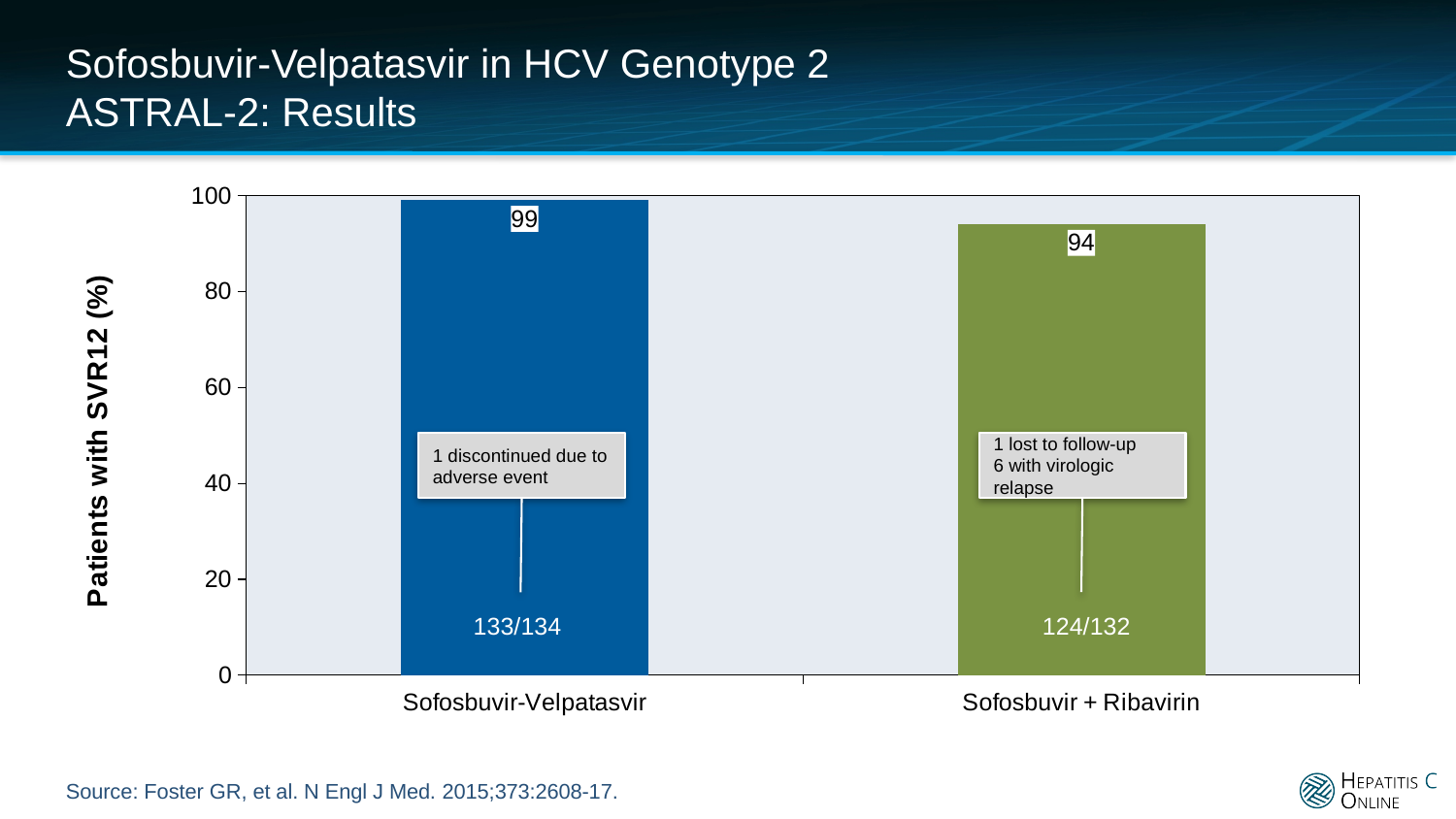
What kind of chart is shown on the slide? Bar chart Which has a larger SVR12 rate, Sofosbuvir-Velpatasvir or Sofosbuvir + Ribavirin? Sofosbuvir-Velpatasvir What is the SVR12 rate for Sofosbuvir + Ribavirin? 94 Which treatment arm has the lowest SVR12 rate? Sofosbuvir + Ribavirin What is the difference in SVR12 rate between Sofosbuvir-Velpatasvir and Sofosbuvir + Ribavirin? 5 What is the label of the y-axis? Patients with SVR12 (%) What fraction of patients is shown inside the Sofosbuvir-Velpatasvir bar? 133/134 What fraction of patients is shown inside the Sofosbuvir + Ribavirin bar? 124/132 Which treatment arm has the highest SVR12 rate? Sofosbuvir-Velpatasvir How many treatment arms are shown in the chart? 2 What is the SVR12 rate for Sofosbuvir-Velpatasvir? 99 Is the value for Sofosbuvir + Ribavirin greater or less than 80? greater